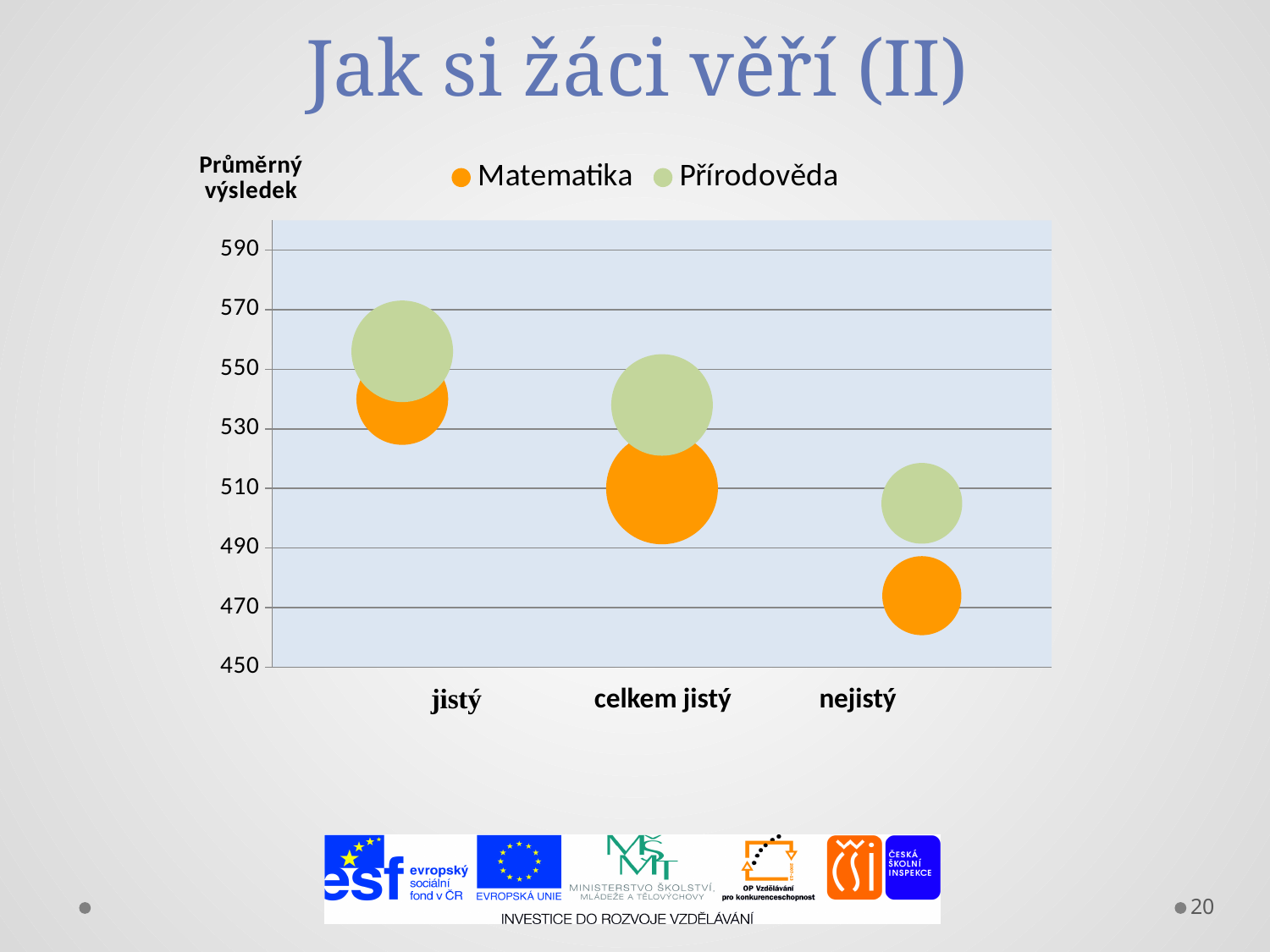
Is the Přírodověda value for nejistý greater or less than 490? greater Is the Matematika value for celkem jistý greater or less than 530? less For which category is the Matematika value highest? jistý What kind of chart is shown on the slide? bubble chart How many categories are shown on the x axis? 3 Is the Matematika value for jistý greater or less than 530? greater How many series does the legend list? 2 For which category is the Přírodověda value lowest? nejistý Which series are listed in the legend? Matematika and Přírodověda What is the label of the vertical axis? Průměrný výsledek Do the Matematika values rise or fall from jistý to nejistý? fall